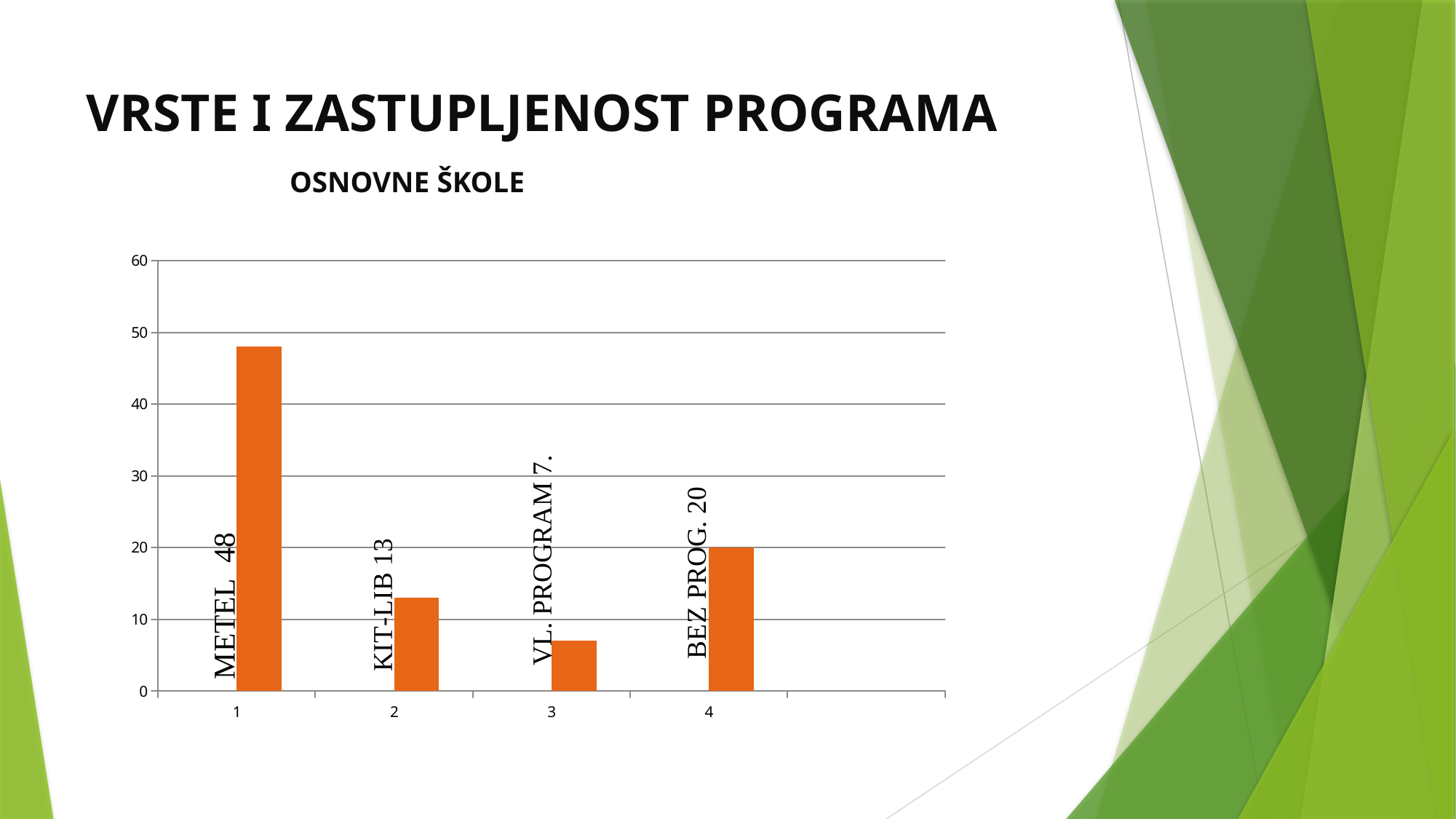
What is the title of the chart? OSNOVNE ŠKOLE What is the value for KIT-LIB? 13 Is the value for METEL greater or less than 40? greater Which category has the lowest value? VL. PROGRAM What is the value for BEZ PROG.? 20 Which category has the highest value? METEL How many bars are plotted in the chart? 4 What is the value for METEL? 48 What is the difference between the values for METEL and BEZ PROG.? 28 What is the highest value shown on the vertical axis? 60 Which is larger, the value for KIT-LIB or the value for BEZ PROG.? BEZ PROG. What kind of chart is shown on the slide? bar chart